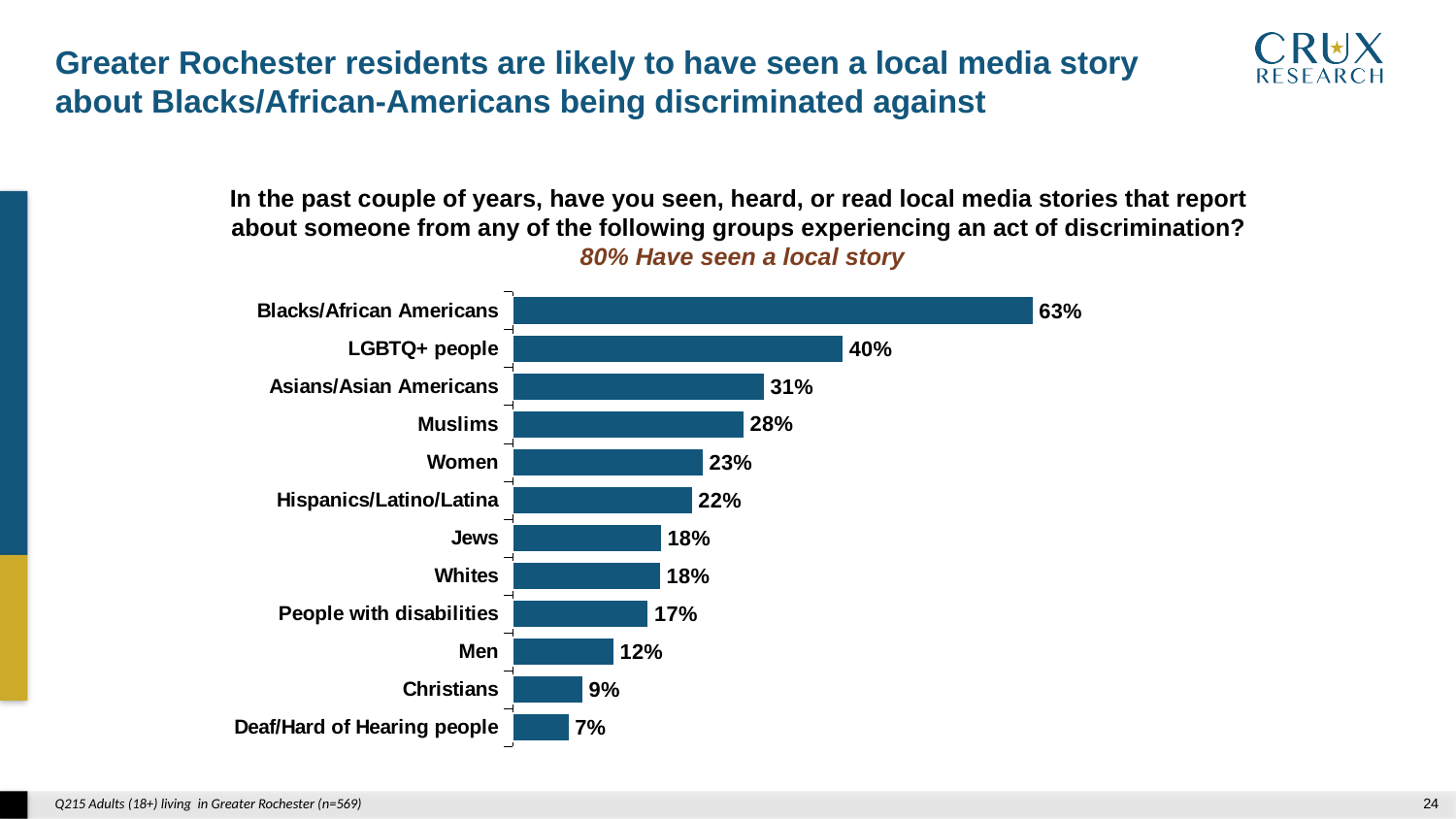
What is the value shown for Muslims? 28% Which has a higher value, Asians/Asian Americans or Hispanics/Latino/Latina? Asians/Asian Americans What is the difference in percentage points between Women and Men? 11 How many groups are shown in the chart? 12 What is the difference in percentage points between Blacks/African Americans and LGBTQ+ people? 23 According to the subtitle above the chart, what percentage have seen a local story? 80% Which group has the highest percentage in the chart? Blacks/African Americans Which group has the lowest percentage in the chart? Deaf/Hard of Hearing people What is the value shown for Deaf/Hard of Hearing people? 7% What is the value shown for LGBTQ+ people? 40% What percentage of respondents have seen a local media story about Blacks/African Americans experiencing discrimination? 63% What type of chart is shown on the slide? Bar chart